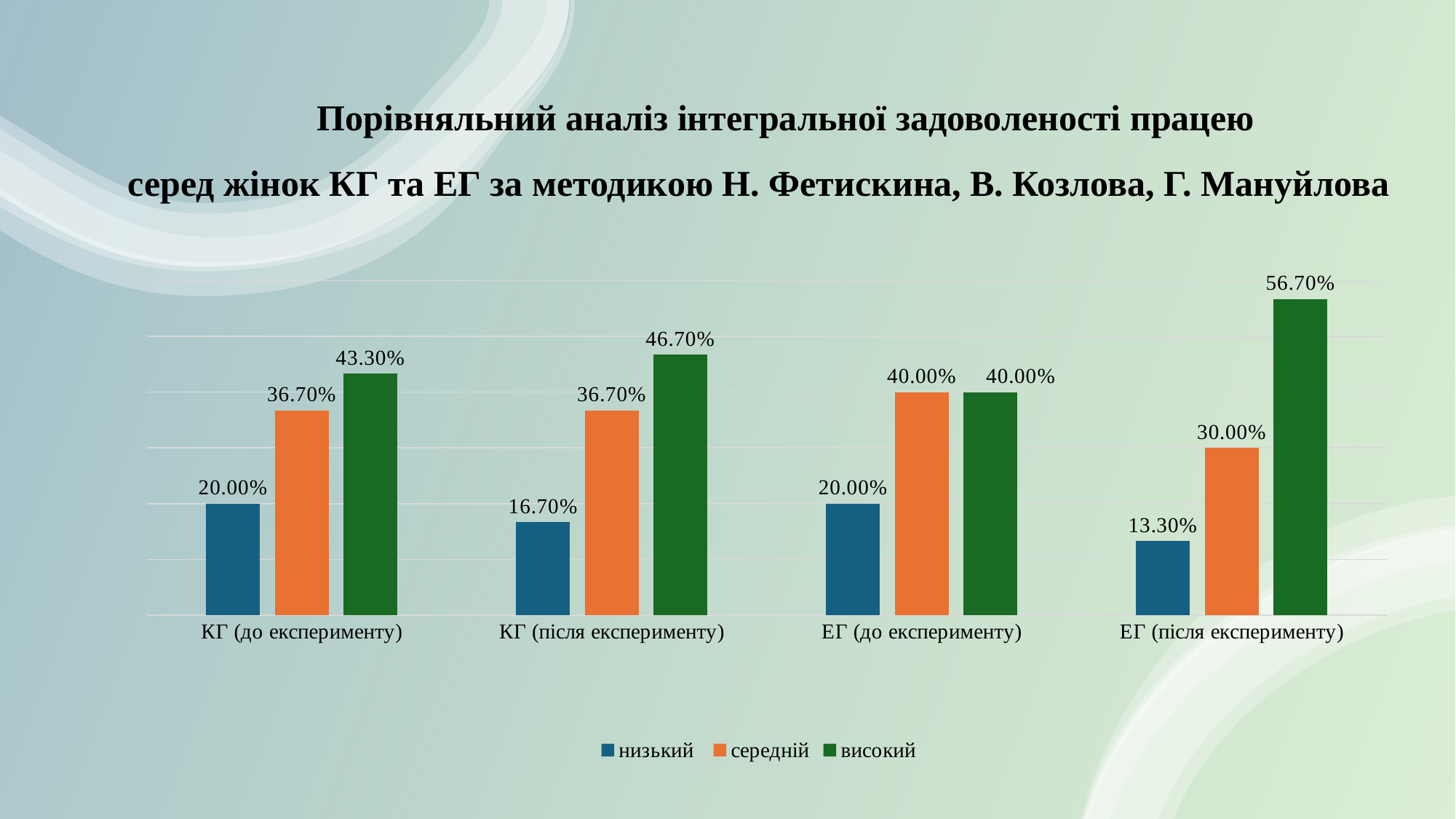
Which category has the highest 'високий' value? ЕГ (після експерименту) What kind of chart is shown on the slide? bar chart What is the value of the 'високий' series for 'ЕГ (після експерименту)'? 56.70% What is the difference between the 'високий' values for 'ЕГ (після експерименту)' and 'ЕГ (до експерименту)'? 16.70% How many categories are shown on the x axis? 4 Which colour represents the 'середній' series in the legend? orange What is the value of the 'середній' series for 'ЕГ (після експерименту)'? 30.00% Does the 'низький' value rise or fall from 'ЕГ (до експерименту)' to 'ЕГ (після експерименту)'? fall Which is larger: the 'середній' value for 'КГ (до експерименту)' or the 'середній' value for 'ЕГ (до експерименту)'? ЕГ (до експерименту) How many series does the legend list? 3 What is the value of the 'низький' series for 'КГ (після експерименту)'? 16.70% Which category has the lowest 'низький' value? ЕГ (після експерименту)